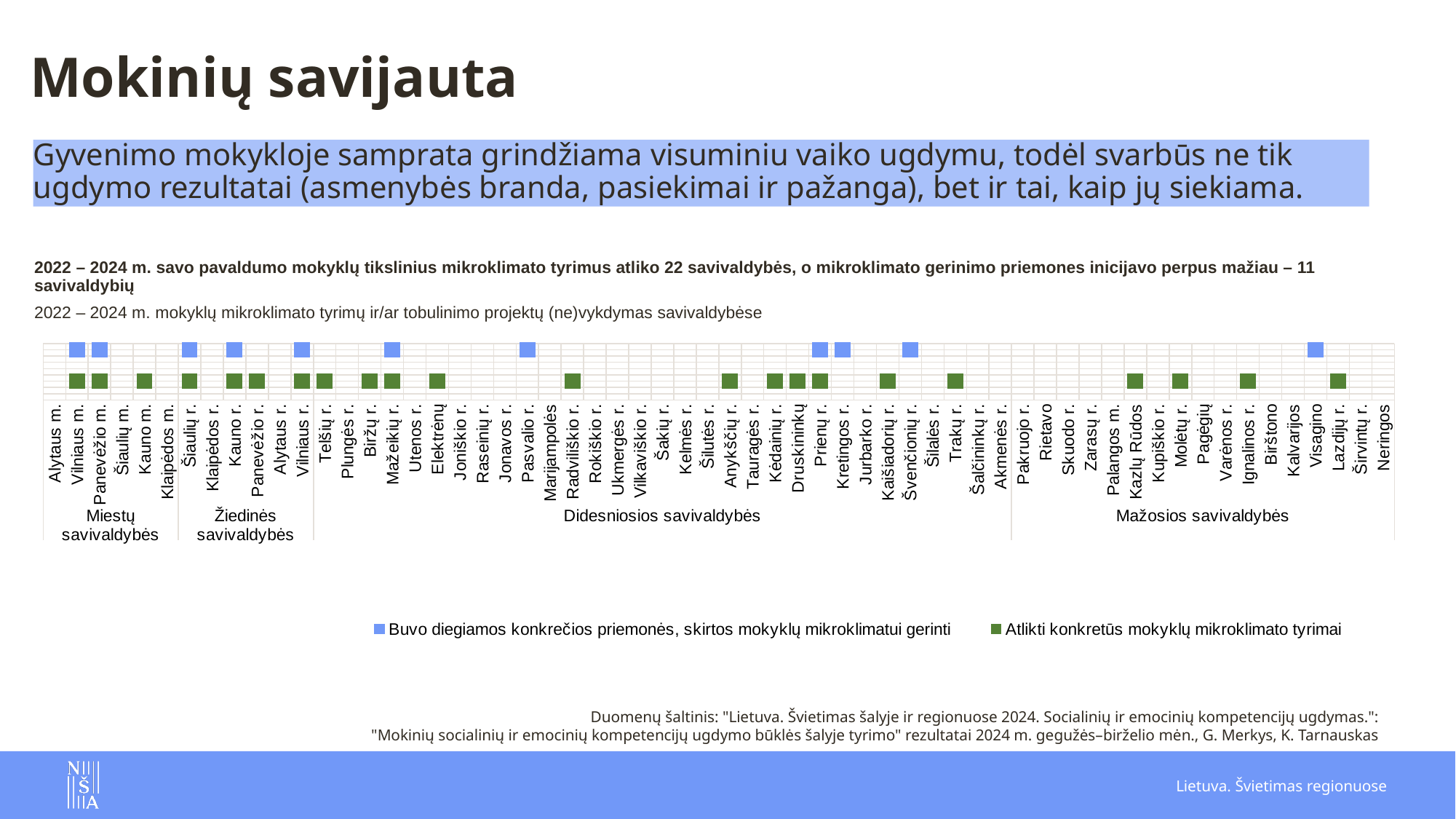
How many municipalities are marked as having implemented specific measures to improve school microclimate (blue markers)? 11 Which colour marks the series 'Atlikti konkretūs mokyklų mikroklimato tyrimai'? Green How many series does the legend list? 2 How many municipality groups are shown along the x axis of the chart? 4 Does Vilniaus m. have markers for both series in the chart? Yes How many municipalities are marked as having conducted specific school microclimate studies (green markers)? 22 Which municipality group contains the most municipalities on the x axis? Didesniosios savivaldybės Which municipalities in the 'Žiedinės savivaldybės' group have a green marker (studies conducted)? Šiaulių r., Kauno r., Panevėžio r., Vilniaus r. Which municipality in the 'Mažosios savivaldybės' group has a blue marker (measures implemented)? Visagino Which municipalities in the 'Miestų savivaldybės' group have a blue marker (measures implemented)? Vilniaus m., Panevėžio m. Does Alytaus m. have a marker for either series in the chart? No What are the two legend entries of the chart? Buvo diegiamos konkrečios priemonės, skirtos mokyklų mikroklimatui gerinti; Atlikti konkretūs mokyklų mikroklimato tyrimai